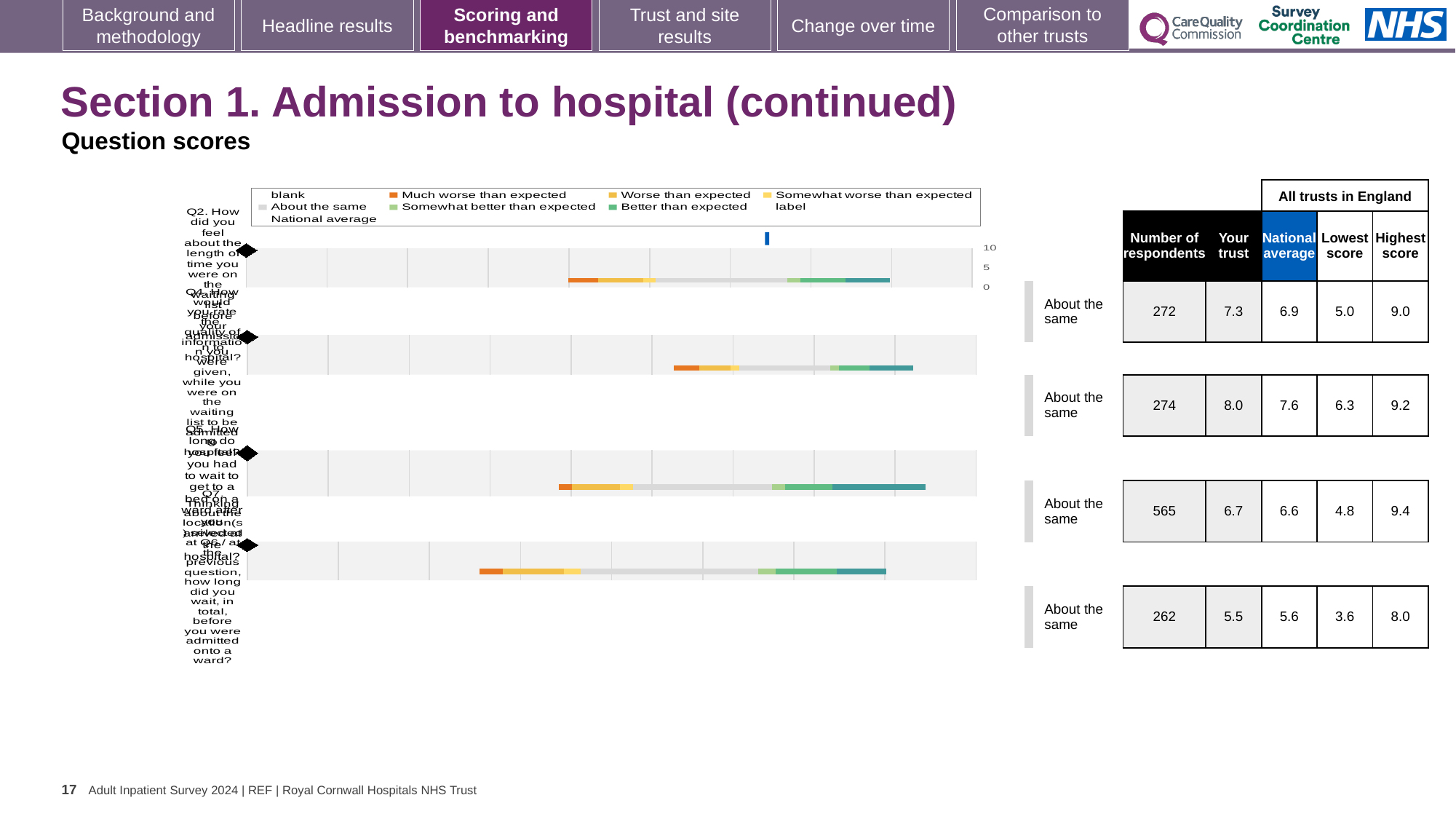
How many question bars are plotted in the chart? 4 In the fourth row of the table, which is larger: the 'Your trust' score or the national average? national average What benchmark label is shown next to each of the four bars? About the same What kind of chart is shown on the slide? bar chart Which row of the table has the highest 'Your trust' score? the second row (8.0) In the table beside the chart, what is the national average for the fourth (bottom) row? 5.6 In the second row of the table, what is the difference between the highest score and the lowest score? 2.9 In the table beside the chart, what is the 'Your trust' score for the first (top) row? 7.3 Which row of the table has the lowest number of respondents? the fourth row (262) What colour represents 'Much worse than expected' in the chart legend? orange In the first row of the table, what is the difference between the 'Your trust' score and the national average? 0.4 In the table beside the chart, what is the number of respondents for the third row? 565